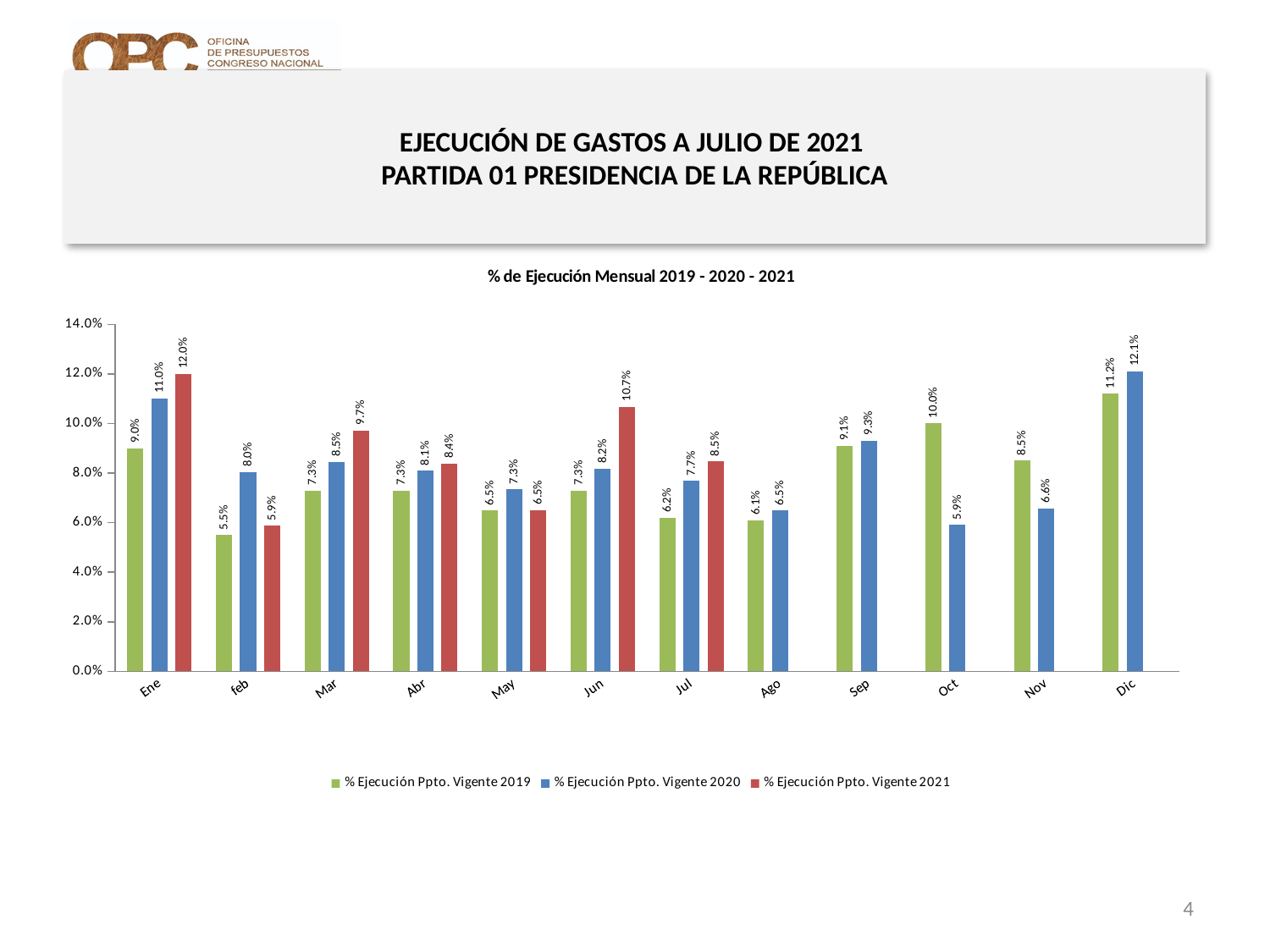
What is the value for % Ejecución Ppto. Vigente 2020 in Dic? 12.1% In which month is the % Ejecución Ppto. Vigente 2021 series lowest? feb In which month is the % Ejecución Ppto. Vigente 2020 series highest? Dic What kind of chart is shown on the slide? Bar chart What is the value for % Ejecución Ppto. Vigente 2021 in Ene? 12.0% How many series does the legend list? 3 What is the difference between the 2021 and 2019 values in Jun? 3.4% What is the title of the chart? % de Ejecución Mensual 2019 - 2020 - 2021 Which is larger in Oct: the 2019 value or the 2020 value? 2019 Is the value for % Ejecución Ppto. Vigente 2021 in Mar greater or less than 8.0%? greater What is the value for % Ejecución Ppto. Vigente 2019 in Oct? 10.0% How many months are shown on the x axis? 12